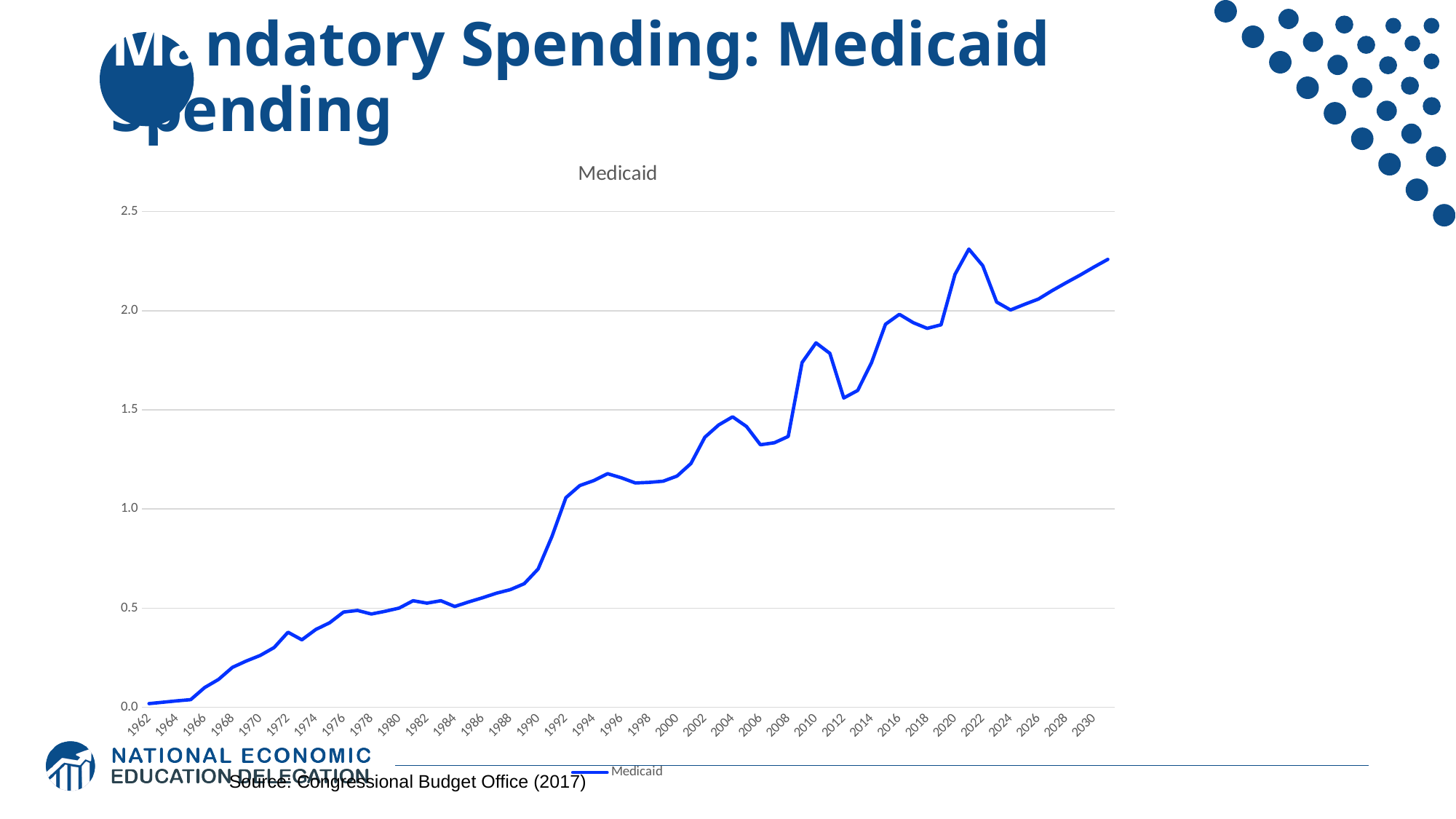
Is the Medicaid value for 2030 greater or less than 2.0? greater Is the Medicaid value for 2006 greater or less than 1.5? less Is the Medicaid value for 1980 greater or less than 1.0? less How many series does the chart's legend list? 1 What is the name of the series shown in the legend? Medicaid What is the title of the chart? Medicaid Which year has the larger Medicaid value, 1970 or 1990? 1990 Which year has the lowest Medicaid value on the chart? 1962 Which year has the larger Medicaid value, 2000 or 2010? 2010 Overall, do the Medicaid values rise or fall from 1962 to 2030? rise What kind of chart is shown on the slide? line chart